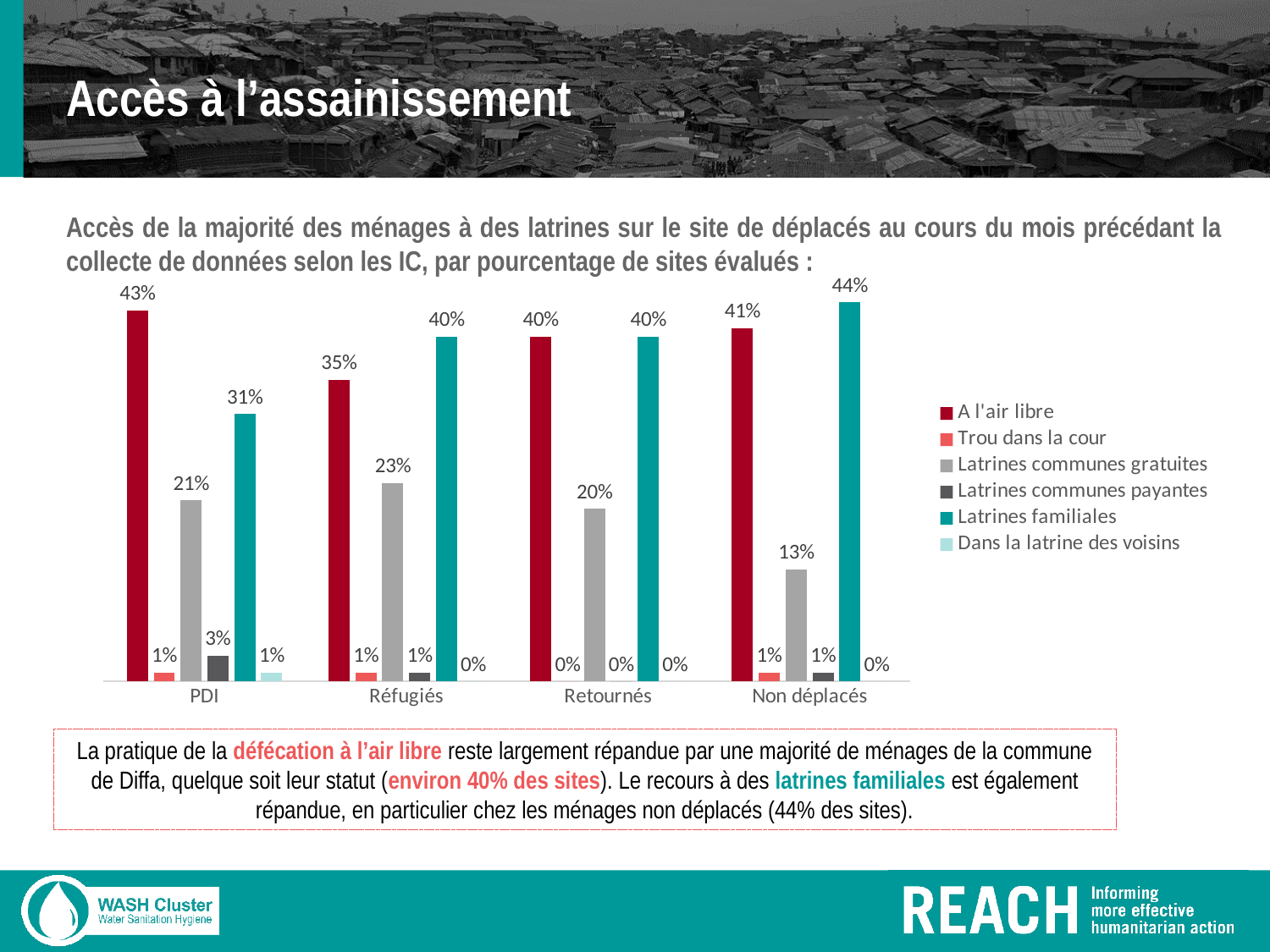
Which colour represents "Latrines familiales" in the legend? Teal What kind of chart is shown on the slide? Bar chart What is the value for "A l'air libre" in the PDI category? 43% What is the difference between "A l'air libre" for PDI and for Réfugiés? 8% Which category has the lowest value for "Latrines communes gratuites"? Non déplacés What is the value for "Latrines familiales" in the Non déplacés category? 44% In the Réfugiés category, which is larger: "A l'air libre" or "Latrines familiales"? Latrines familiales Which category has the highest value for "Latrines familiales"? Non déplacés What is the value for "Latrines communes gratuites" in the Réfugiés category? 23% How many categories are shown on the x axis? 4 What is the value for "Latrines communes payantes" in the PDI category? 3% How many series does the legend list? 6